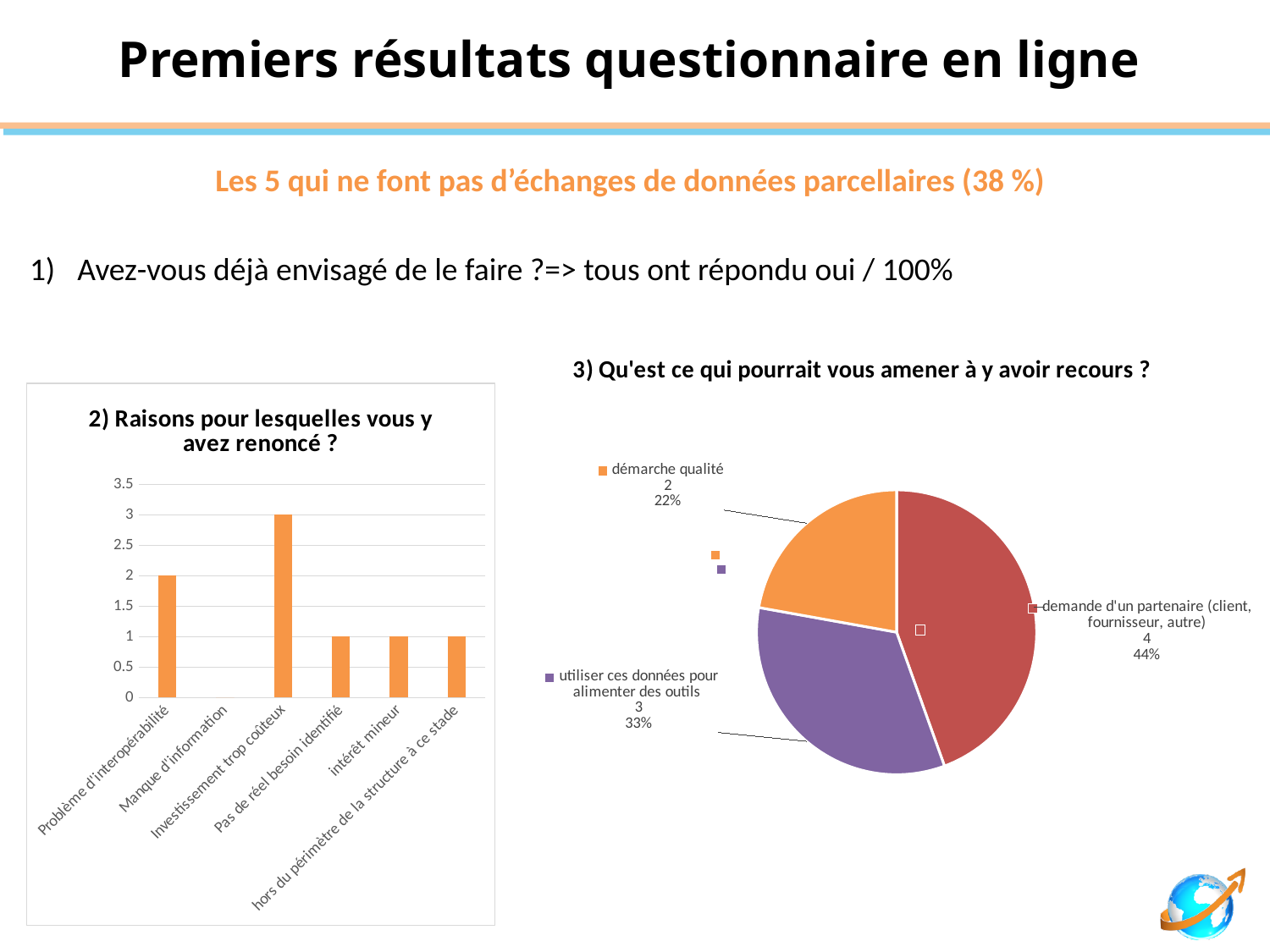
In the bar chart '2) Raisons pour lesquelles vous y avez renoncé ?', which is larger: 'Problème d'interopérabilité' or 'intérêt mineur'? Problème d'interopérabilité In the bar chart '2) Raisons pour lesquelles vous y avez renoncé ?', how many categories are shown on the x axis? 6 What kind of chart is '2) Raisons pour lesquelles vous y avez renoncé ?'? Bar chart In the bar chart '2) Raisons pour lesquelles vous y avez renoncé ?', which category has the lowest value? Manque d'information In the pie chart '3) Qu'est ce qui pourrait vous amener à y avoir recours ?', what is the value for 'utiliser ces données pour alimenter des outils'? 3 In the bar chart '2) Raisons pour lesquelles vous y avez renoncé ?', what is the value for 'Problème d'interopérabilité'? 2 In the bar chart '2) Raisons pour lesquelles vous y avez renoncé ?', what is the difference between 'Investissement trop coûteux' and 'Pas de réel besoin identifié'? 2 In the bar chart '2) Raisons pour lesquelles vous y avez renoncé ?', what is the value for 'Investissement trop coûteux'? 3 In the pie chart '3) Qu'est ce qui pourrait vous amener à y avoir recours ?', what percentage share does 'démarche qualité' have? 22% What kind of chart is '3) Qu'est ce qui pourrait vous amener à y avoir recours ?'? Pie chart In the pie chart '3) Qu'est ce qui pourrait vous amener à y avoir recours ?', which slice is the largest? demande d'un partenaire (client, fournisseur, autre) In the bar chart '2) Raisons pour lesquelles vous y avez renoncé ?', which category has the highest value? Investissement trop coûteux